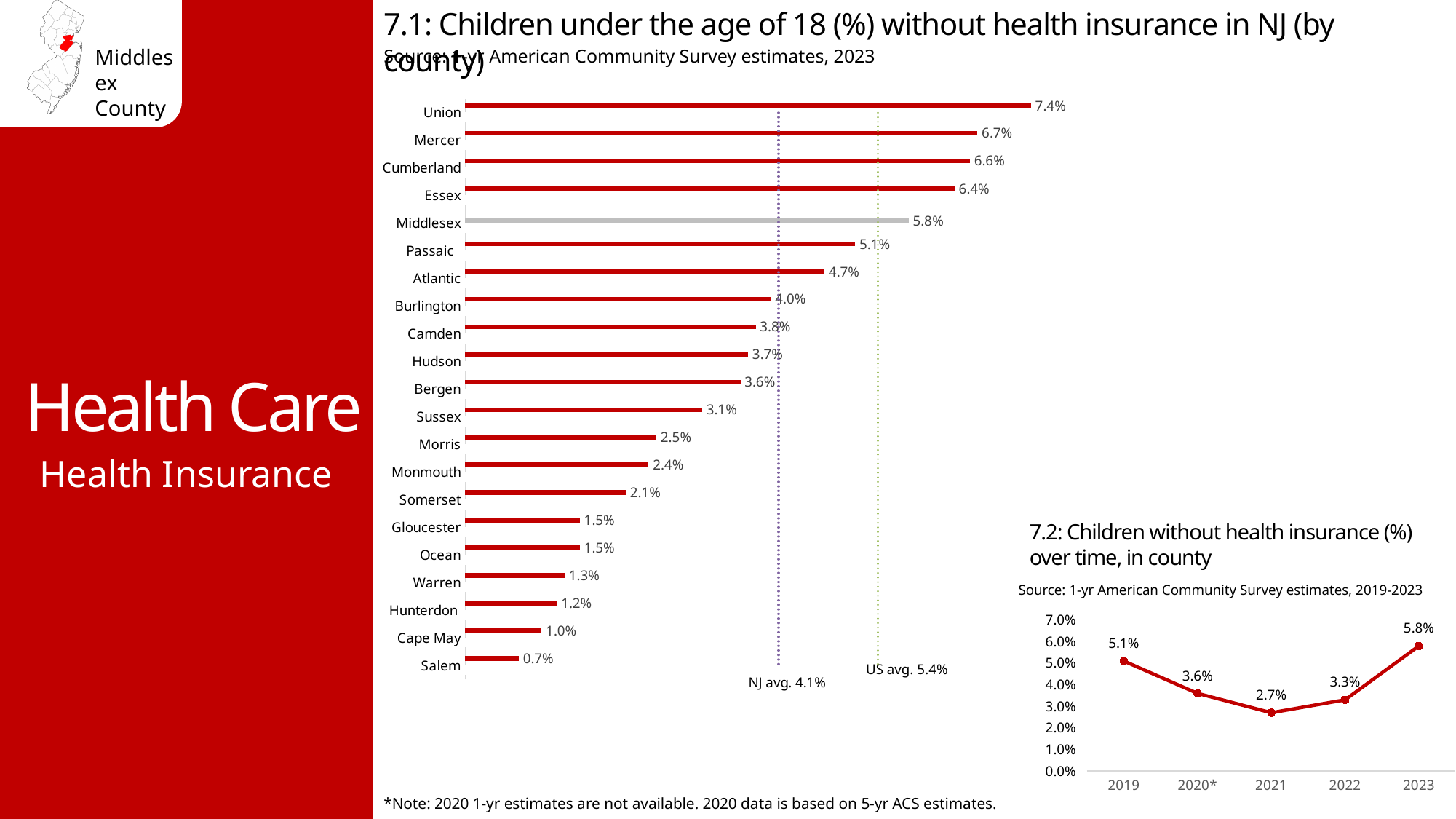
In chart 7.2, what is the value for 2021? 2.7% What kind of chart is chart 7.2 (children without health insurance over time)? Line chart In chart 7.1, which county has the highest percentage of children without health insurance? Union In chart 7.1, what is the difference between the values for Union and Salem? 6.7% In chart 7.1 (children under 18 without health insurance by county), what is the value for Middlesex? 5.8% In chart 7.1, how many counties are shown? 21 In chart 7.2, what is the difference between the 2023 value and the 2022 value? 2.5% In chart 7.1, which county has the lowest percentage of children without health insurance? Salem In chart 7.1, what is the value for Hudson? 3.7% In chart 7.2, how many years are plotted? 5 In chart 7.1, which county has a higher value, Essex or Passaic? Essex In chart 7.1, what is the NJ average shown by the dotted reference line? 4.1%